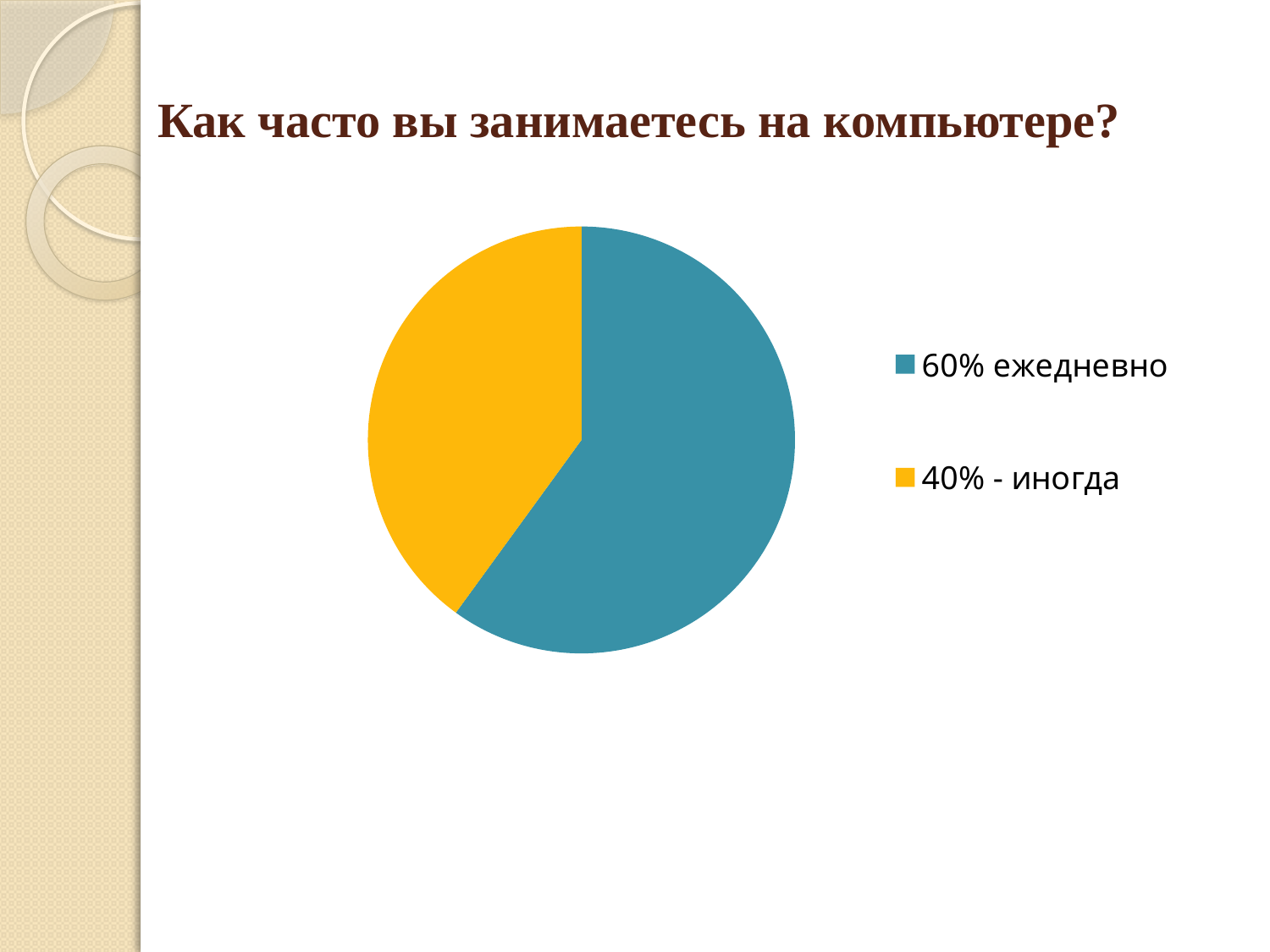
Which slice is the largest in the pie chart? 60% ежедневно What colour is the 'ежедневно' slice? teal blue What is the title of the slide above the chart? Как часто вы занимаетесь на компьютере? What is the difference in percentage points between the 'ежедневно' and 'иногда' slices? 20% How many slices does the pie chart have? 2 What share of the pie does the 'ежедневно' slice represent? 60% Which is larger, the 'ежедневно' slice or the 'иногда' slice? ежедневно How many entries does the legend list? 2 What share of the pie does the 'иногда' slice represent? 40% What kind of chart is shown on the slide? pie chart Which slice is the smallest in the pie chart? 40% - иногда